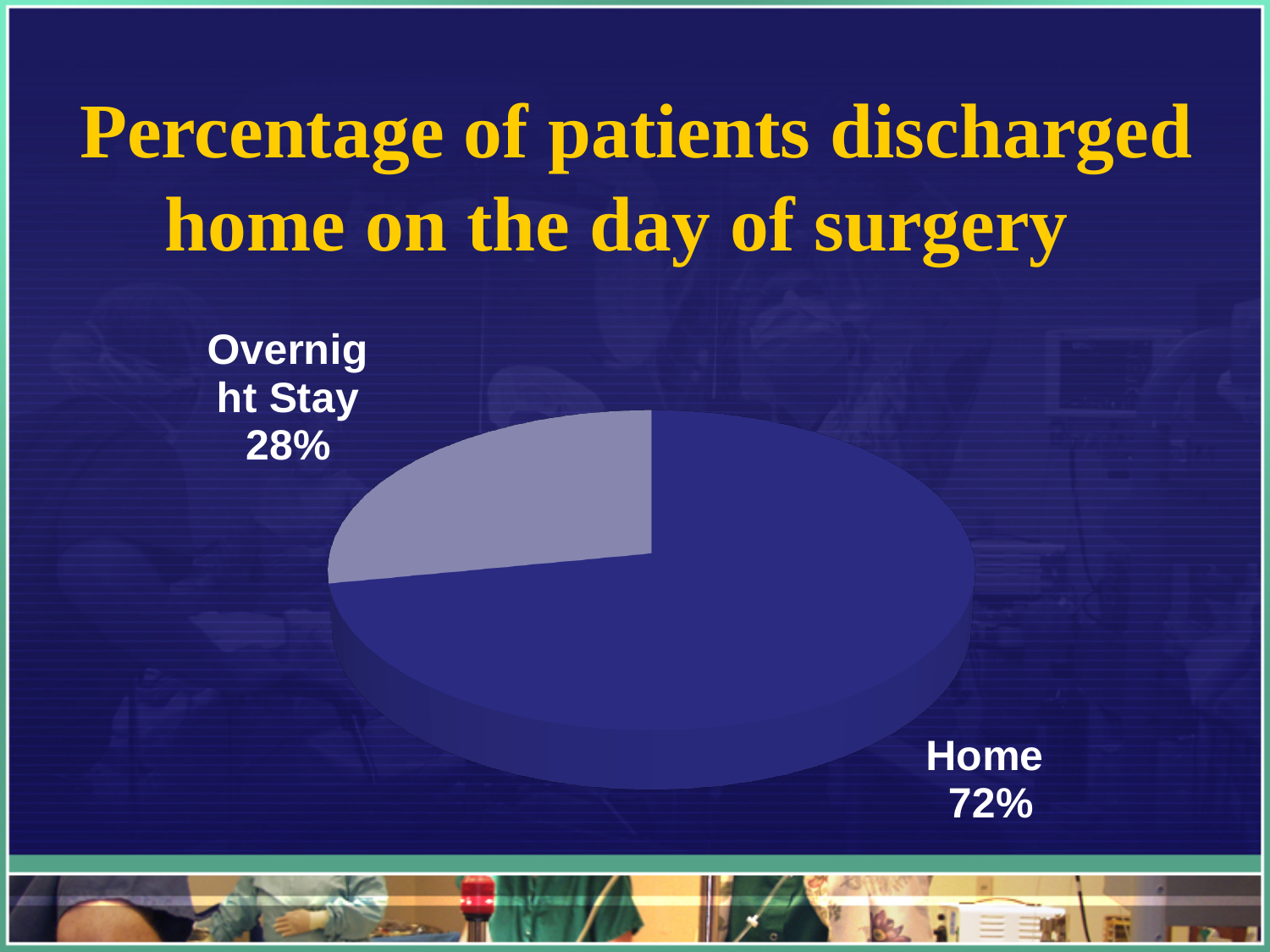
What is the difference in percentage points between Home and Overnight Stay? 44 What kind of chart is shown on the slide? pie chart What percentage of patients were discharged Home? 72% Which slice is shown in the lighter colour? Overnight Stay Which category has the smallest share of the pie? Overnight Stay Which is larger, the share for Home or the share for Overnight Stay? Home What is the title of the chart? Percentage of patients discharged home on the day of surgery What share of the pie does the Home slice represent? 72% How many slices does the pie chart have? 2 What percentage of patients had an Overnight Stay? 28% Which category has the largest share of the pie? Home